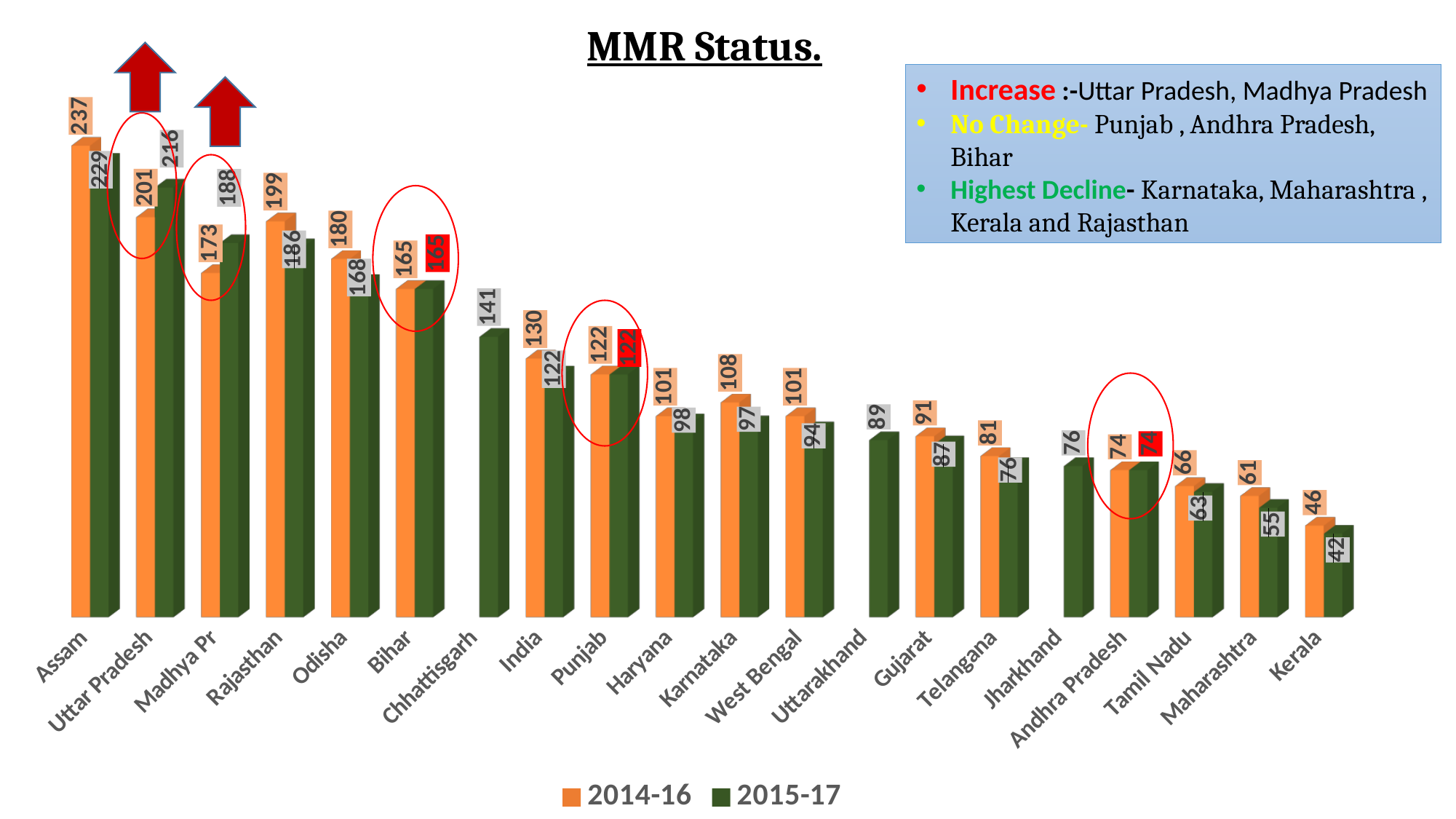
Do the 2015-17 values generally rise or fall from left to right along the x axis? Fall Which is larger for Rajasthan: the 2014-16 value or the 2015-17 value? 2014-16 What is the 2014-16 value for Assam? 237 What is the 2015-17 value for Uttar Pradesh? 216 How many categories are shown on the x axis? 20 Which category has the lowest 2014-16 value? Kerala What is the difference between the 2014-16 and 2015-17 values for Madhya Pr? 15 What is the 2015-17 value for Chhattisgarh? 141 How many series does the legend list? 2 Which category has the highest 2015-17 value? Assam What is the 2014-16 value for Karnataka? 108 What kind of chart is shown on the slide? Bar chart